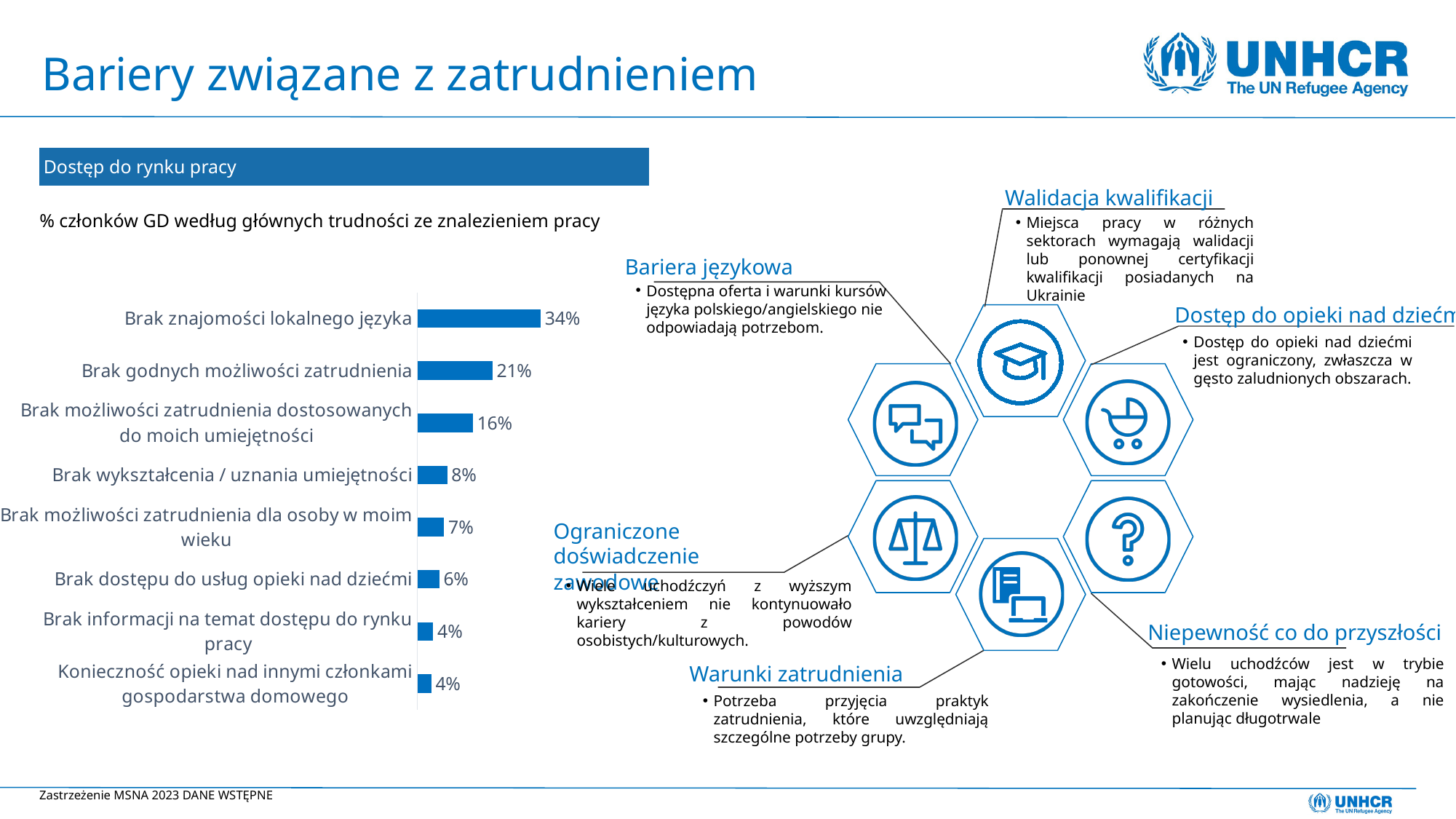
What is the title of the chart? % członków GD według głównych trudności ze znalezieniem pracy What percentage is shown for 'Brak dostępu do usług opieki nad dziećmi'? 6% Which category has the highest value in the chart? Brak znajomości lokalnego języka What percentage is shown for 'Brak godnych możliwości zatrudnienia'? 21% What is the difference between the values for 'Brak możliwości zatrudnienia dostosowanych do moich umiejętności' and 'Brak wykształcenia / uznania umiejętności'? 8% What percentage is shown for 'Brak znajomości lokalnego języka'? 34% What value is shown for 'Brak informacji na temat dostępu do rynku pracy'? 4% Which is larger: the value for 'Brak możliwości zatrudnienia dla osoby w moim wieku' or for 'Brak dostępu do usług opieki nad dziećmi'? Brak możliwości zatrudnienia dla osoby w moim wieku How many categories are shown in the bar chart? 8 What percentage is shown for 'Brak wykształcenia / uznania umiejętności'? 8% What is the difference between the values for 'Brak znajomości lokalnego języka' and 'Brak godnych możliwości zatrudnienia'? 13% What type of chart is shown on the slide? Bar chart